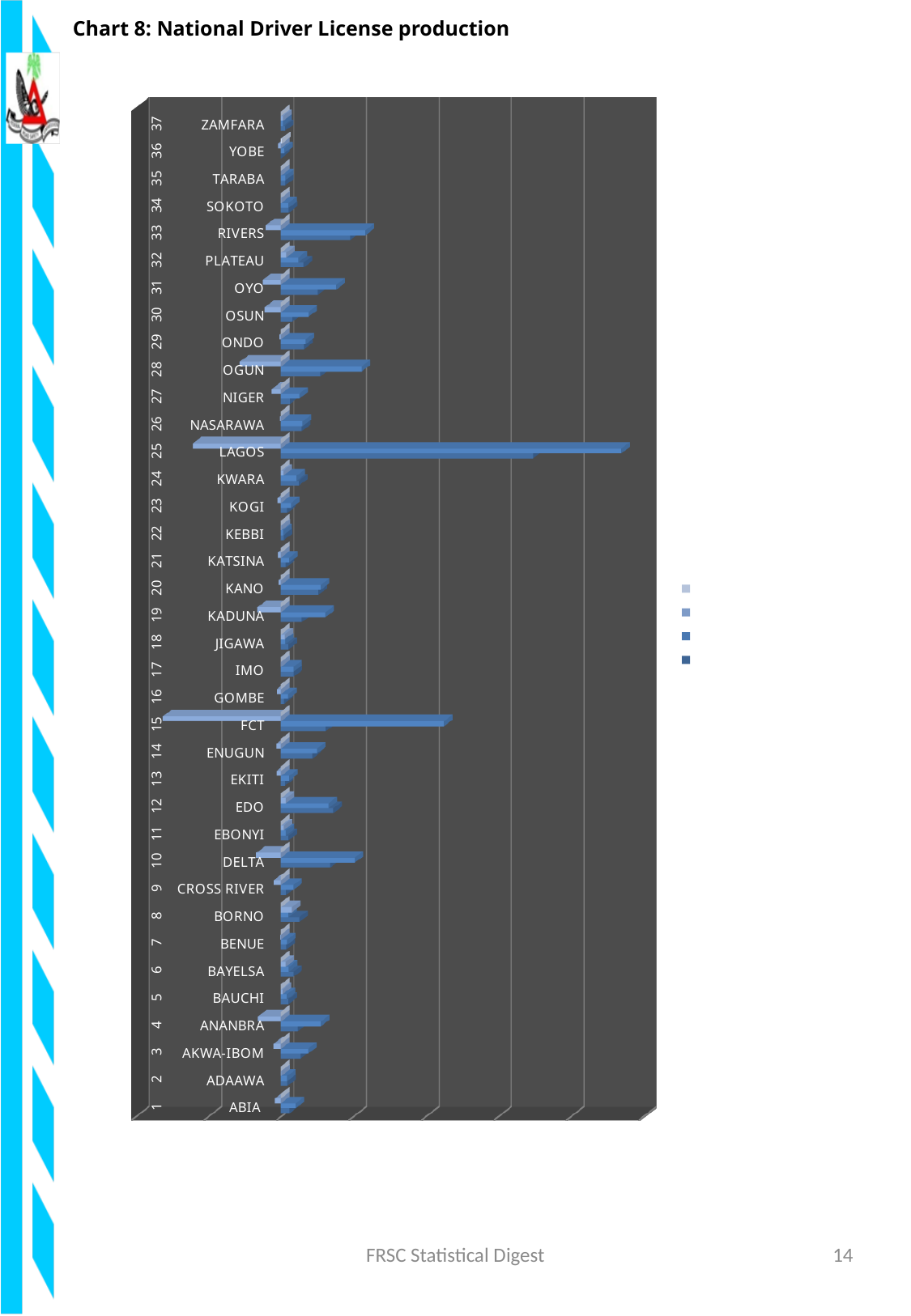
Which state is numbered 25 on the chart's category axis? LAGOS Which has the larger value, LAGOS or OGUN? LAGOS Which has the larger value, RIVERS or YOBE? RIVERS How many series does the legend list? 4 Which state has the highest driver license production on the chart? LAGOS What is the title of the chart? Chart 8: National Driver License production How many states (categories) are listed on the chart? 37 What kind of chart is shown on the slide? bar chart Which has the larger value, LAGOS or FCT? LAGOS